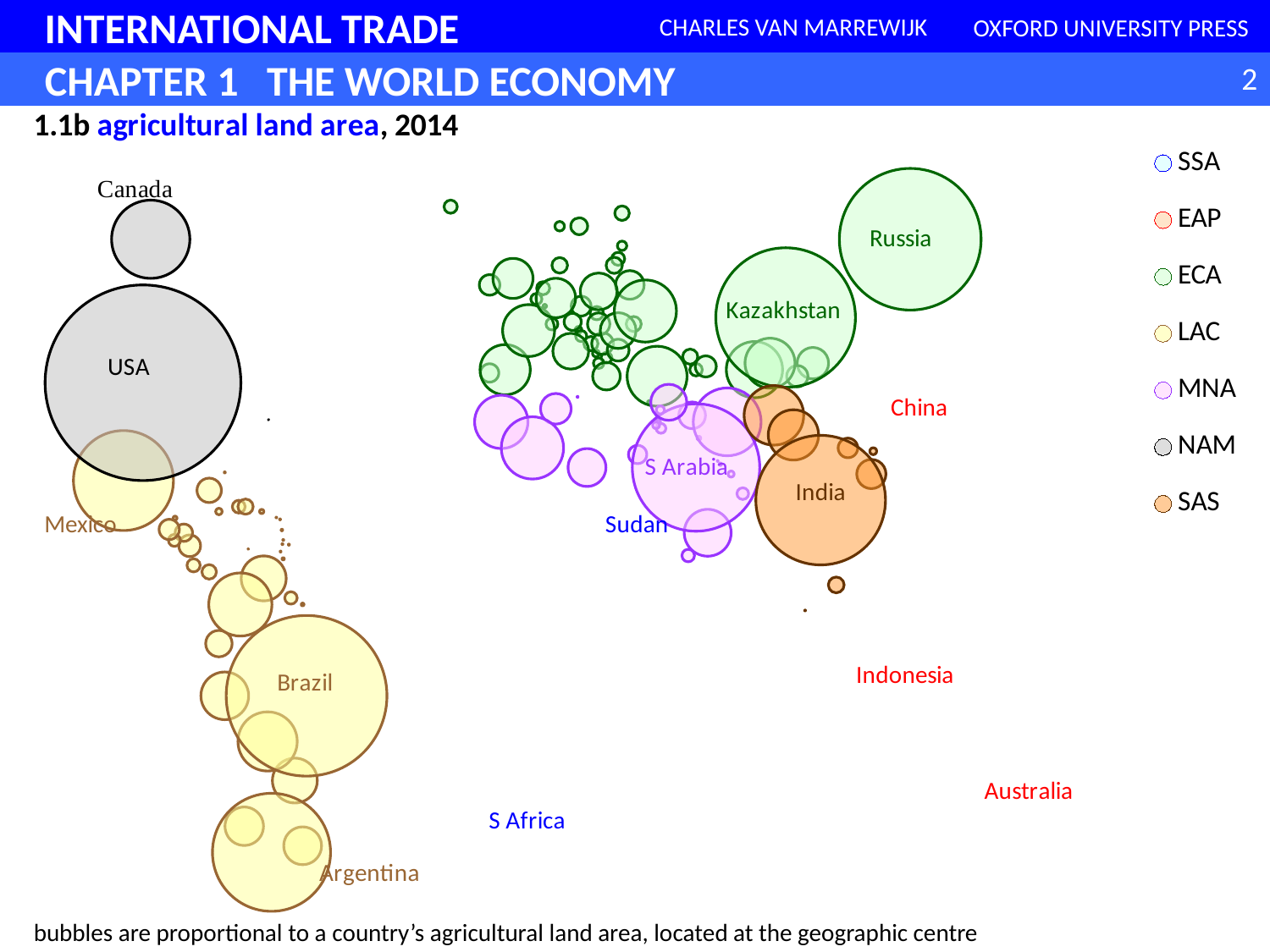
Which region in the legend is shown in green? ECA What does the size of each bubble represent, according to the note at the bottom of the slide? a country's agricultural land area Which has the larger bubble, Brazil or Mexico? Brazil Which has the larger bubble, Russia or Kazakhstan? Russia Which has the larger bubble, S Arabia or Sudan? S Arabia How many regions does the legend list? 7 What is the title of the chart? 1.1b agricultural land area, 2014 What kind of chart is shown on the slide? bubble chart